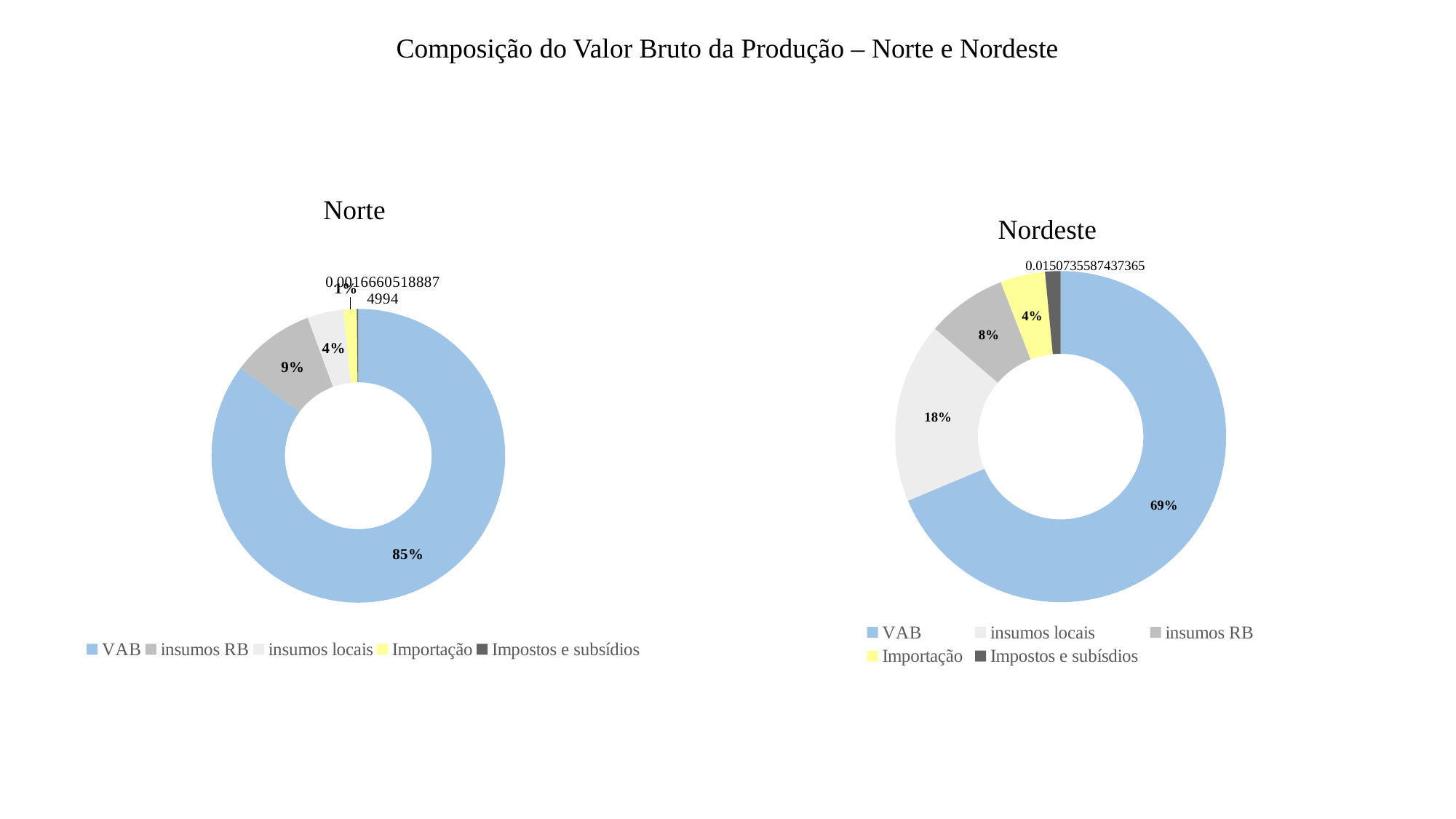
In the Nordeste chart, what share is insumos locais? 18% In the Nordeste chart, which category has the smallest slice? Impostos e subísdios In the Nordeste chart, what share is VAB? 69% What is the title of the slide? Composição do Valor Bruto da Produção – Norte e Nordeste In the Norte chart, what is the difference between the VAB share and the insumos RB share? 76% What kind of chart is used for Norte? Doughnut (pie) chart In the Nordeste chart, what share is Importação? 4% Which chart shows a larger share for insumos locais, Norte or Nordeste? Nordeste In the Norte chart, what share of the Valor Bruto da Produção is VAB? 85% How many categories does the legend of the Nordeste chart list? 5 In the Norte chart, which category has the largest slice? VAB In the Norte chart, what share is insumos RB? 9%